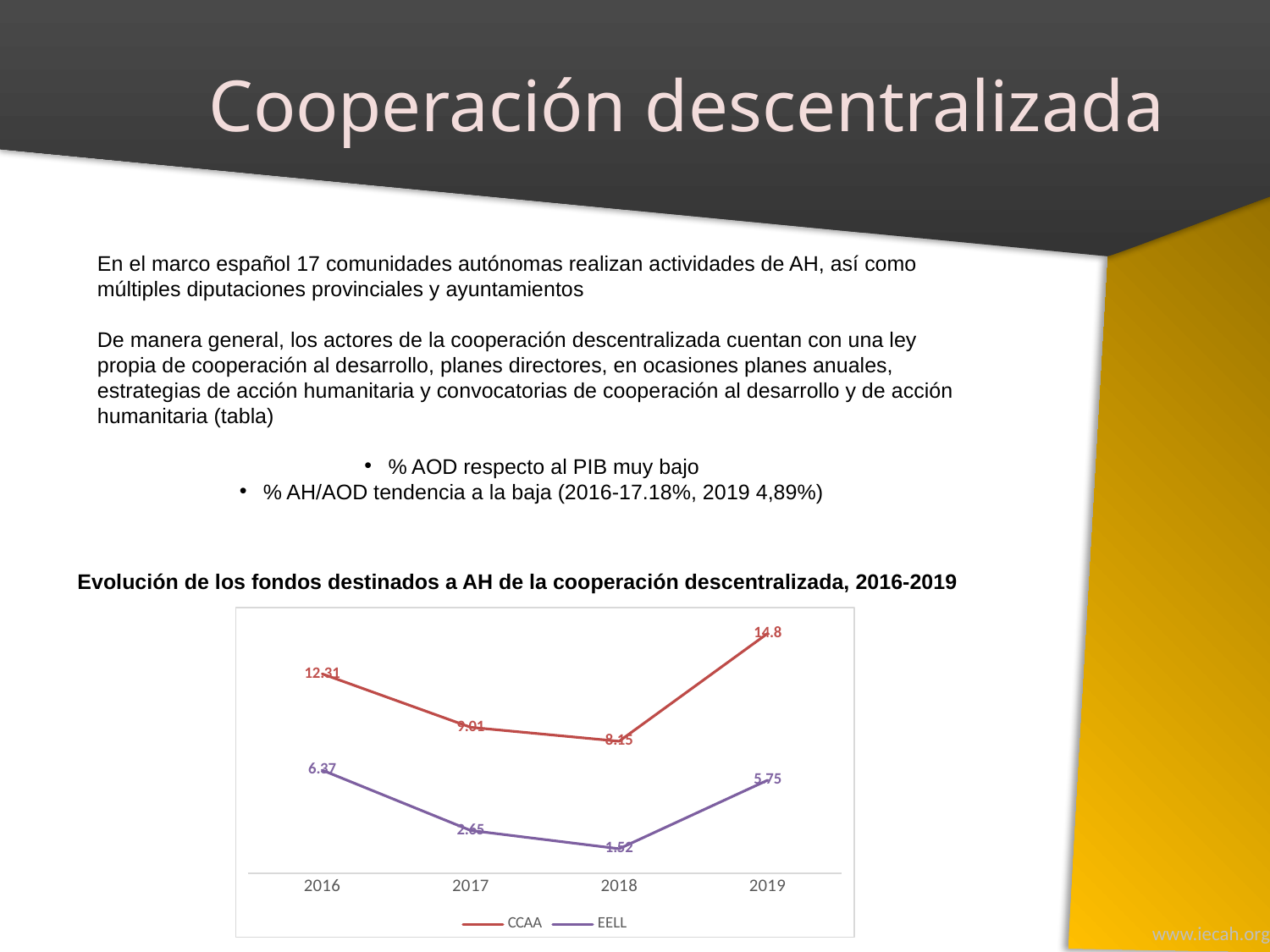
How many series does the legend list? 2 What is the title of the chart? Evolución de los fondos destinados a AH de la cooperación descentralizada, 2016-2019 Which is larger, the CCAA value in 2016 or the CCAA value in 2018? CCAA value in 2016 What type of chart is shown on the slide? line chart How many years are shown on the x axis? 4 In which year is the EELL value lowest? 2018 What is the value for CCAA in 2017? 9.01 What is the difference between the CCAA and EELL values in 2019? 9.05 What is the value for EELL in 2018? 1.52 In which year is the CCAA value highest? 2019 What is the value for EELL in 2016? 6.37 What is the value for CCAA in 2019? 14.8